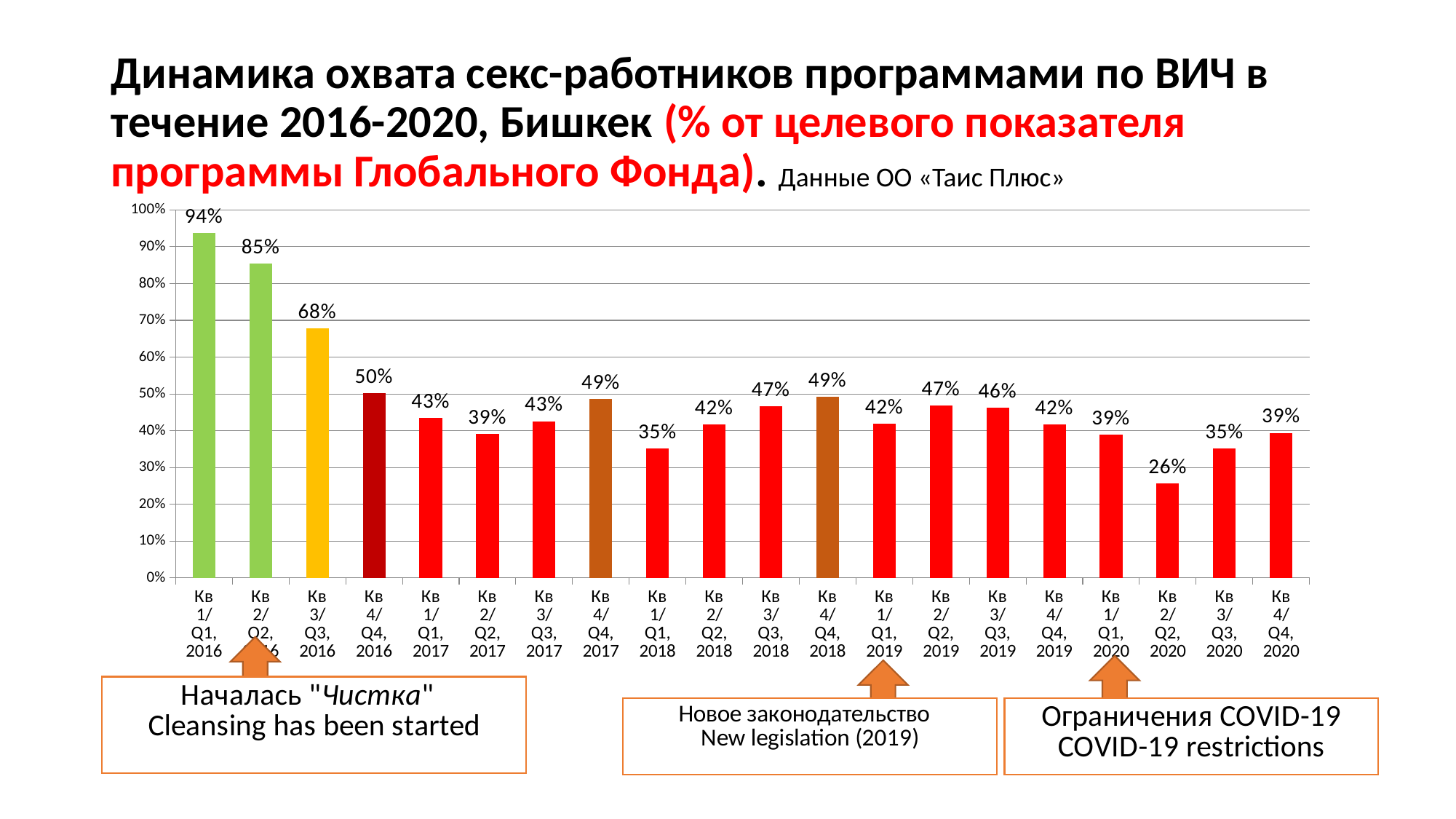
What is the value for Q4 2017? 49% What is the difference between the values for Q3 2016 and Q4 2016? 18% How many quarters (bars) are shown on the chart? 20 What is the value for Q1 2016? 94% What is the difference between the values for Q1 2016 and Q2 2016? 9% What is the value for Q3 2019? 46% What kind of chart is shown on the slide? Bar chart Which is larger, the value for Q1 2018 or the value for Q2 2018? Q2 2018 Which quarter has the lowest value? Q2 2020 Do the values generally rise or fall from Q1 2016 to Q4 2016? Fall Which quarter has the highest value? Q1 2016 What is the value for Q2 2020? 26%